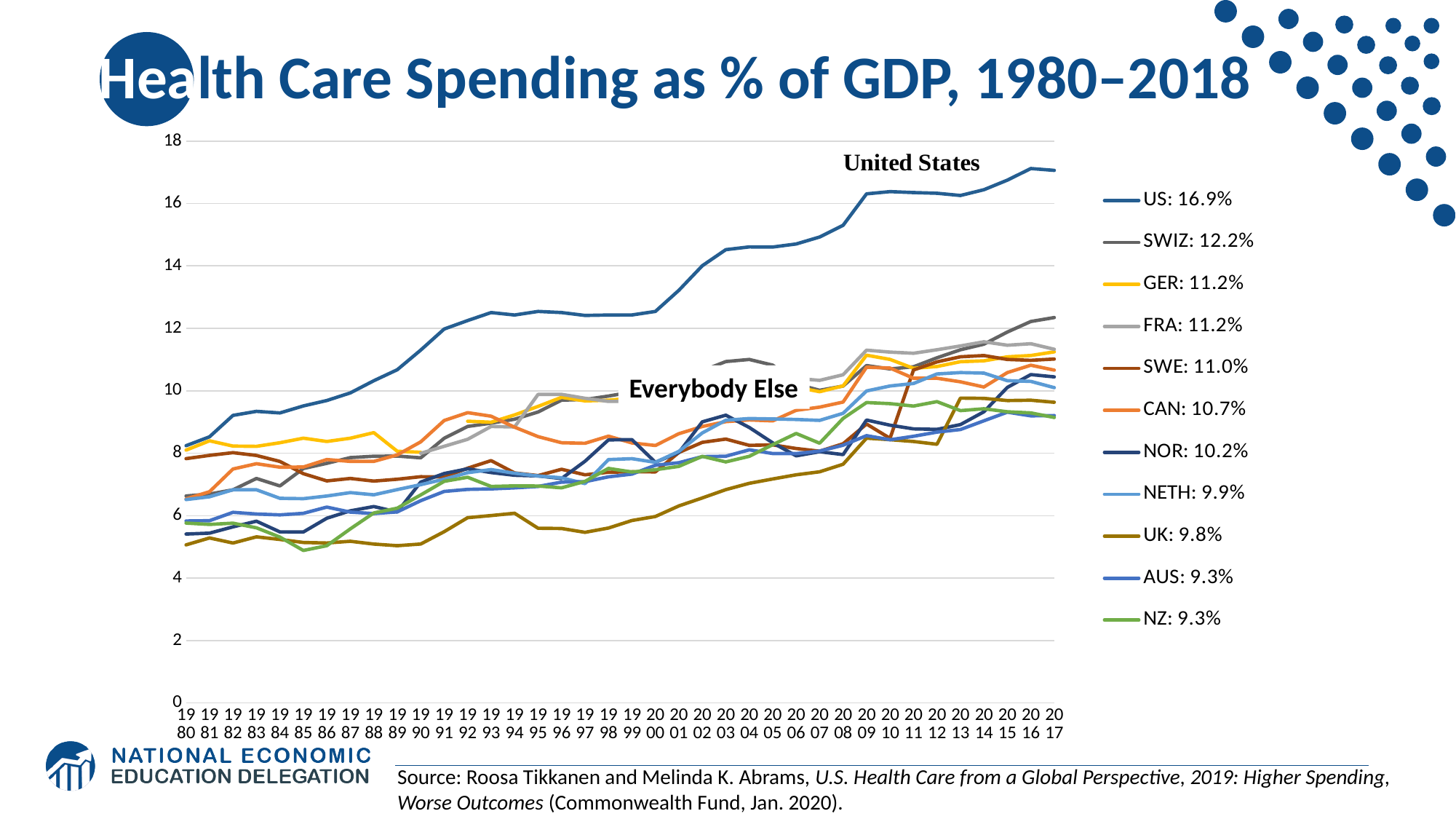
What is the title of the chart? Health Care Spending as % of GDP, 1980–2018 Which has the larger legend value, GER or SWE? GER How many series does the legend list? 11 Is the value for the US line in 2017 greater or less than 16? greater According to the legend, what is the value shown for UK? 9.8% Which country has the highest value in the legend? US According to the legend, what is the value shown for US? 16.9% According to the legend, what is the value shown for SWIZ? 12.2% What is the difference between the legend values for US and SWIZ? 4.7 percentage points Does the US line rise or fall from 1980 to 2017? rise Is the value for the UK line in 1985 greater or less than 6? less What kind of chart is shown on the slide? line chart